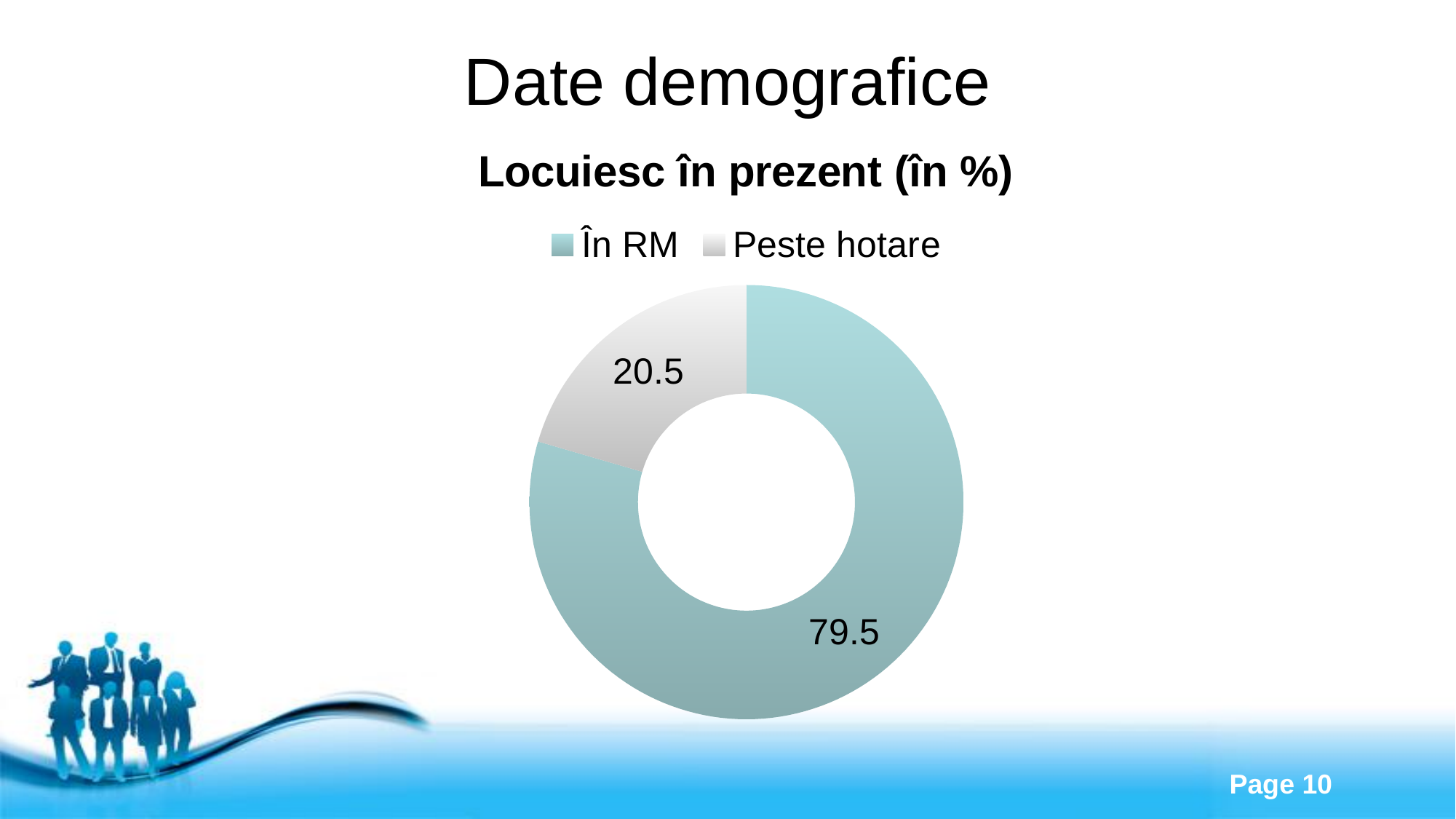
Which category has the smallest share of the chart? Peste hotare Which category has the largest share of the chart? În RM What is the value for În RM? 79.5 What is the value for Peste hotare? 20.5 Which is larger, the value for În RM or the value for Peste hotare? În RM How many entries does the legend list? 2 What is the total of the two values shown in the chart? 100 Which category is shown in the teal colour? În RM What is the title of the chart? Locuiesc în prezent (în %) What kind of chart is shown on the slide? Doughnut (pie) chart How many categories are shown in the chart? 2 What is the difference between the values for În RM and Peste hotare? 59